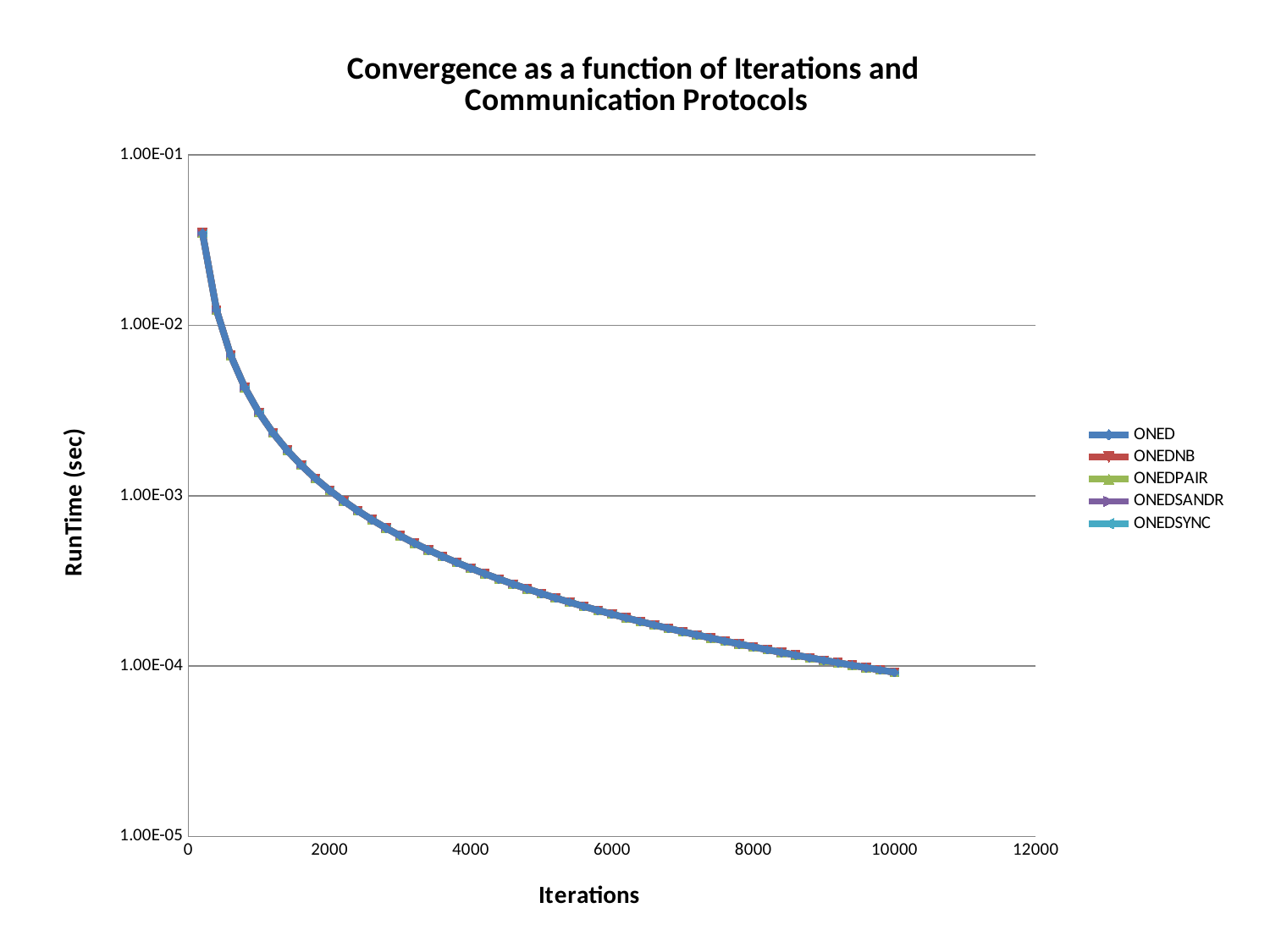
Is the RunTime value for ONED at 4000 iterations greater or less than 1.00E-03? less Which series is the last one listed in the legend? ONEDSYNC Do the RunTime values rise or fall as Iterations increase? fall How many series does the legend list? 5 Is the RunTime value for ONED at 1000 iterations greater or less than 1.00E-02? less What is the title of the chart? Convergence as a function of Iterations and Communication Protocols Is the RunTime value for ONED at the first plotted point (about 200 iterations) greater or less than 1.00E-02? greater What kind of chart is shown on the slide? line chart What is the label of the y axis? RunTime (sec)